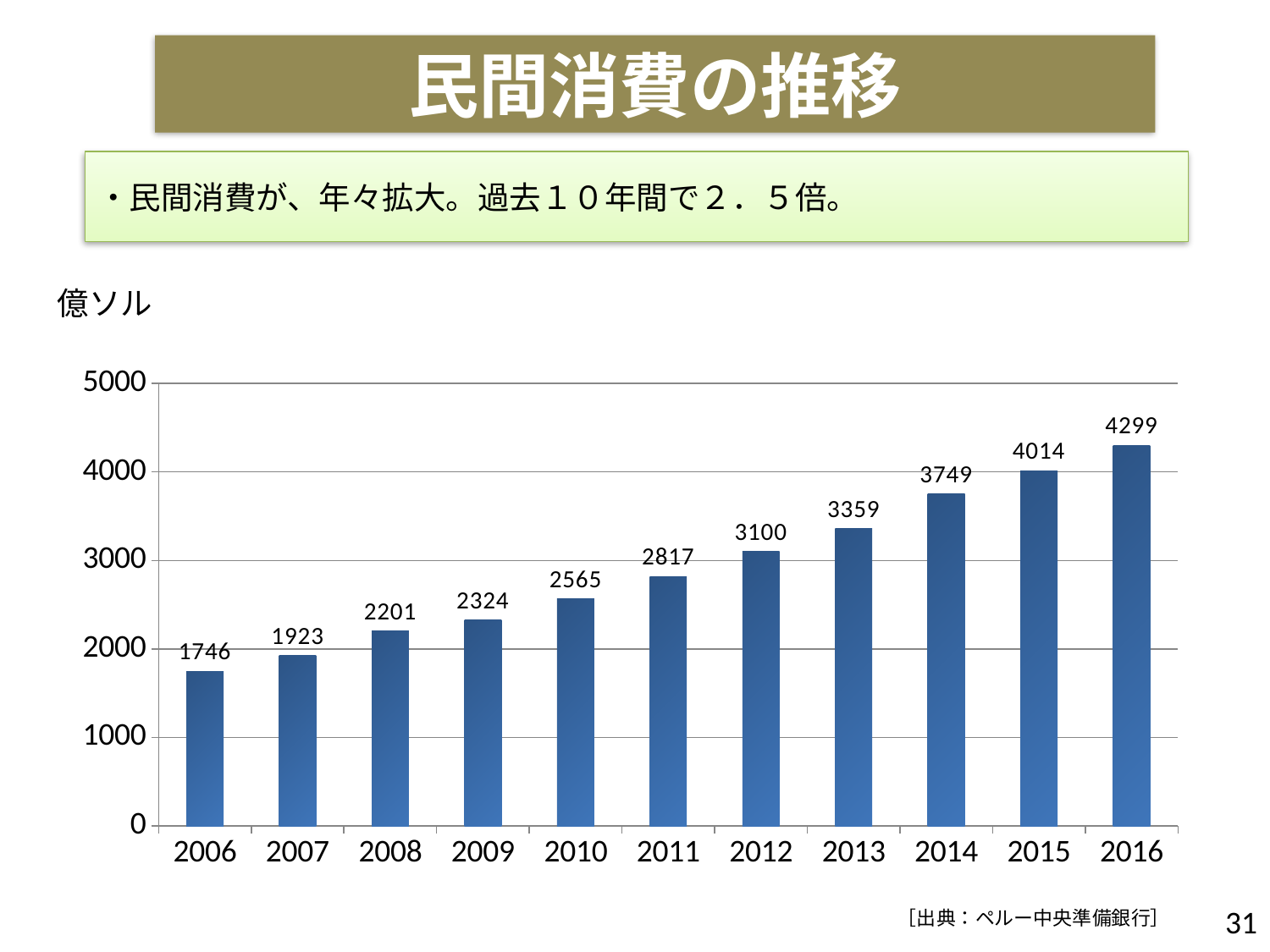
What is the difference between the values for 2016 and 2006? 2553 Do the values rise or fall from 2006 to 2016? rise Is the value for 2013 greater or less than 3000? greater Which year has the lowest value? 2006 Which year has the highest value? 2016 How many years are shown on the x axis? 11 Which is larger, the value for 2010 or the value for 2011? 2011 What is the value for 2016? 4299 What is the value for 2012? 3100 What is the difference between the values for 2015 and 2014? 265 What kind of chart is shown on the slide? bar chart What is the value for 2006? 1746